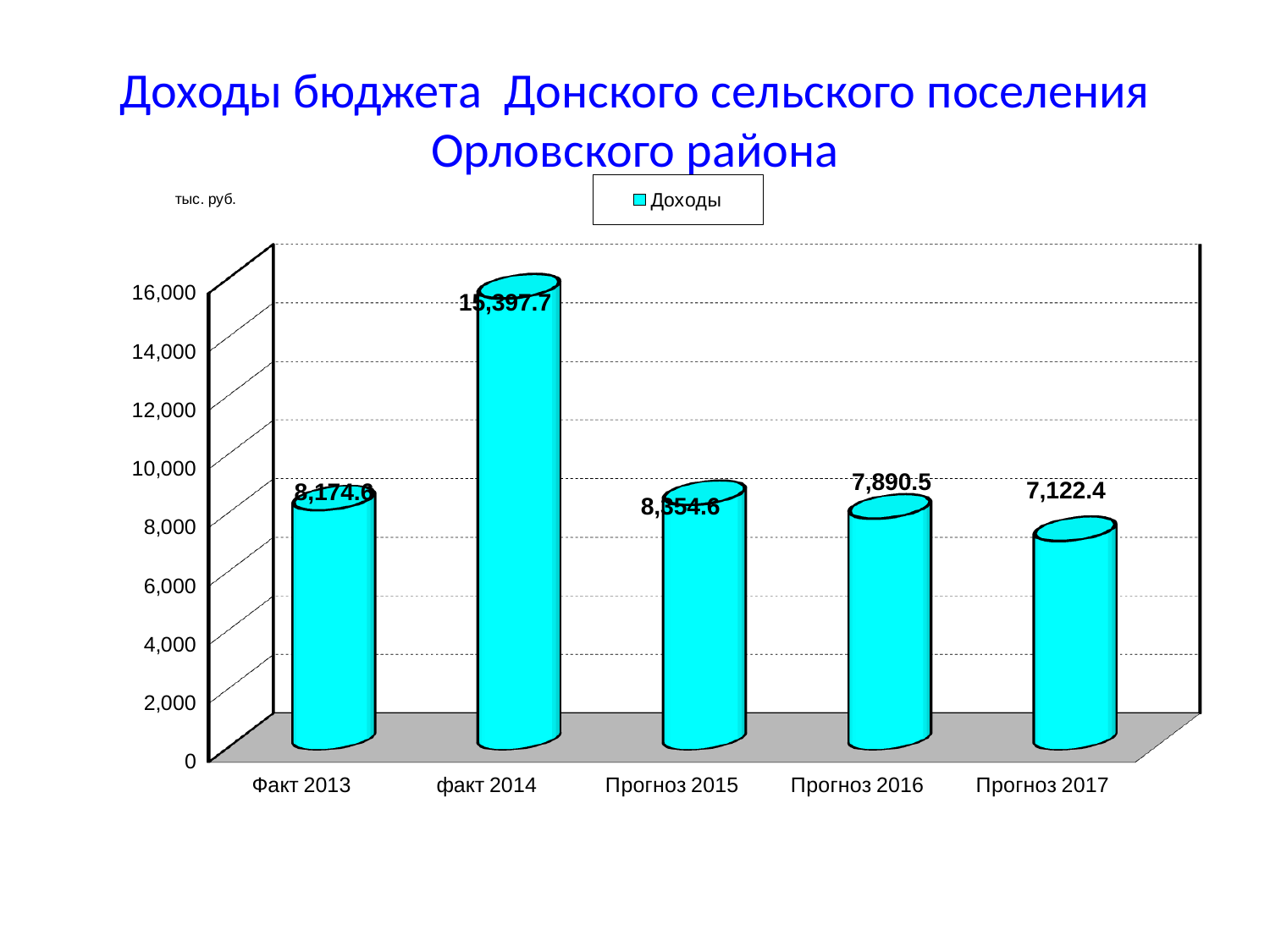
What is the value for Прогноз 2016? 7,890.5 What is the value for факт 2014? 15,397.7 What type of chart is shown on the slide? bar chart How many categories are shown on the x axis of the chart? 5 Which is larger, the value for Прогноз 2016 or the value for Прогноз 2017? Прогноз 2016 What is the difference between the values for Прогноз 2016 and Прогноз 2017? 768.1 Is the value for факт 2014 greater or less than 14,000? greater What is the name of the series shown in the legend? Доходы What is the value for Прогноз 2017? 7,122.4 Which category has the lowest value? Прогноз 2017 How many series does the legend list? 1 Which category has the highest value? факт 2014